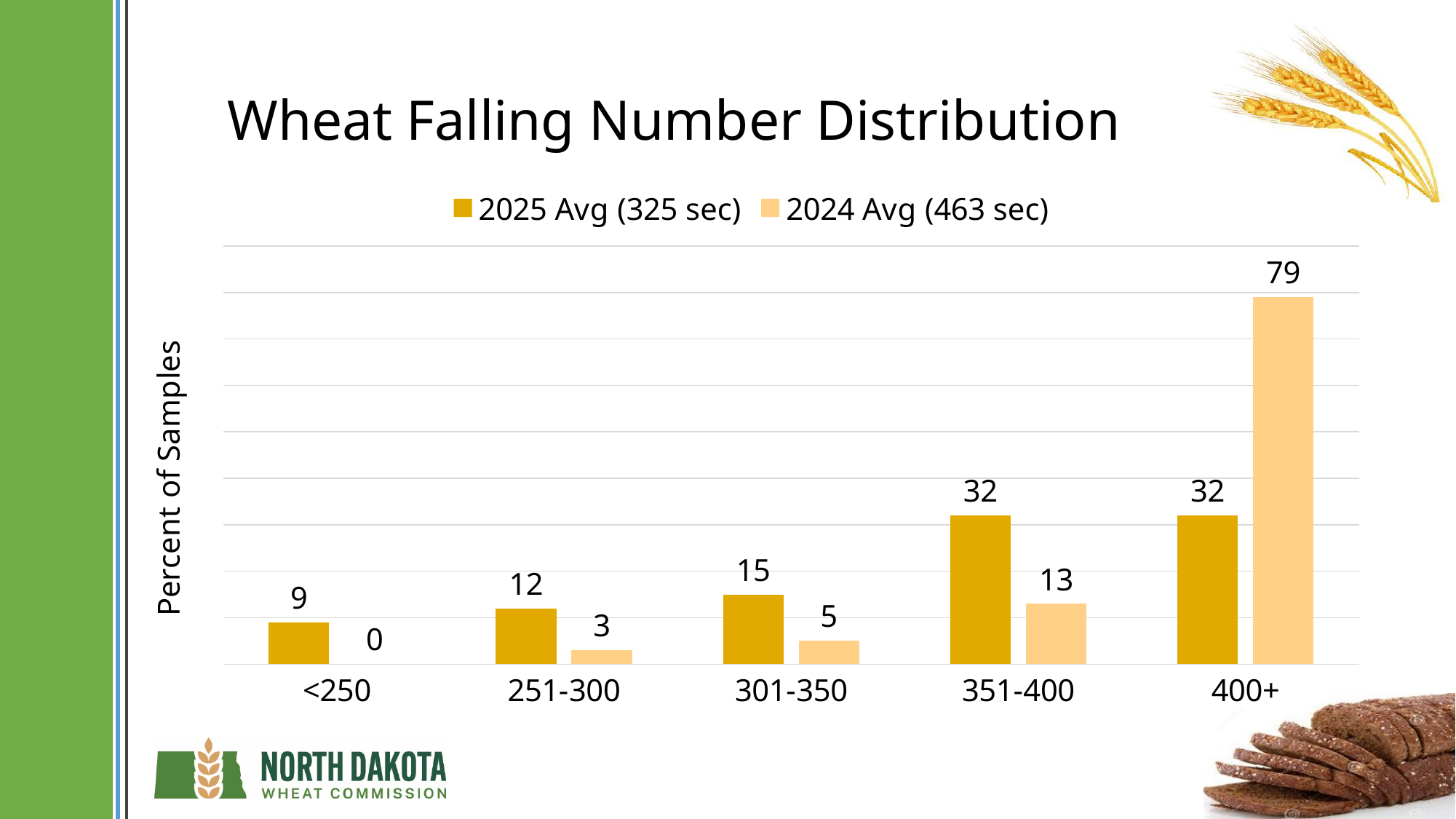
What kind of chart is shown on the slide? bar chart What is the value for 2025 Avg (325 sec) in the 301-350 category? 15 How many categories are shown on the x axis? 5 Which category has the highest value for the 2024 Avg (463 sec) series? 400+ Which category has the lowest value for the 2025 Avg (325 sec) series? <250 What is the difference between the 2024 Avg (463 sec) and 2025 Avg (325 sec) values in the 400+ category? 47 In the 351-400 category, which series has the larger value? 2025 Avg (325 sec) How many series does the legend list? 2 What is the label of the y axis? Percent of Samples Do the values for the 2025 Avg (325 sec) series rise or fall from <250 to 351-400? rise What is the value for 2024 Avg (463 sec) in the 400+ category? 79 What is the value for 2024 Avg (463 sec) in the <250 category? 0